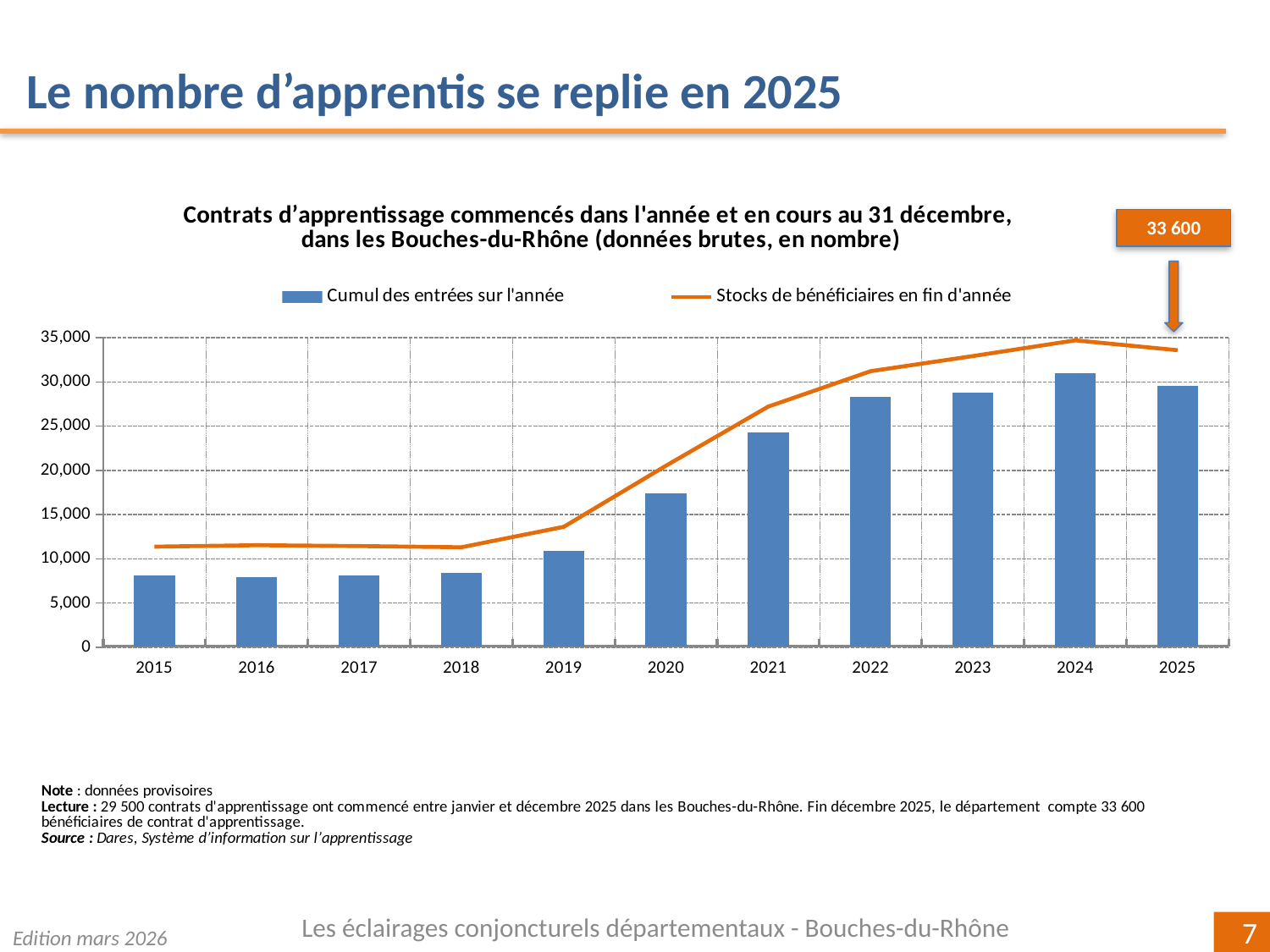
Does the 'Stocks de bénéficiaires en fin d'année' line rise or fall between 2018 and 2024? It rises Is the bar value for 2019 greater or less than 15,000? less What value is shown in the callout for the stock of beneficiaries at the end of 2025? 33 600 How many years are shown on the x axis? 11 Which year has the larger bar, 2024 or 2025? 2024 What kind of chart is shown on the slide? A combined bar and line chart Which year has the larger bar, 2021 or 2022? 2022 What colour is the line for 'Stocks de bénéficiaires en fin d'année'? Orange How many series does the legend list? 2 In which year is the bar for 'Cumul des entrées sur l'année' the highest? 2024 Is the bar value for 2020 greater or less than 15,000? greater Is the 'Stocks de bénéficiaires en fin d'année' value for 2015 greater or less than 15,000? less